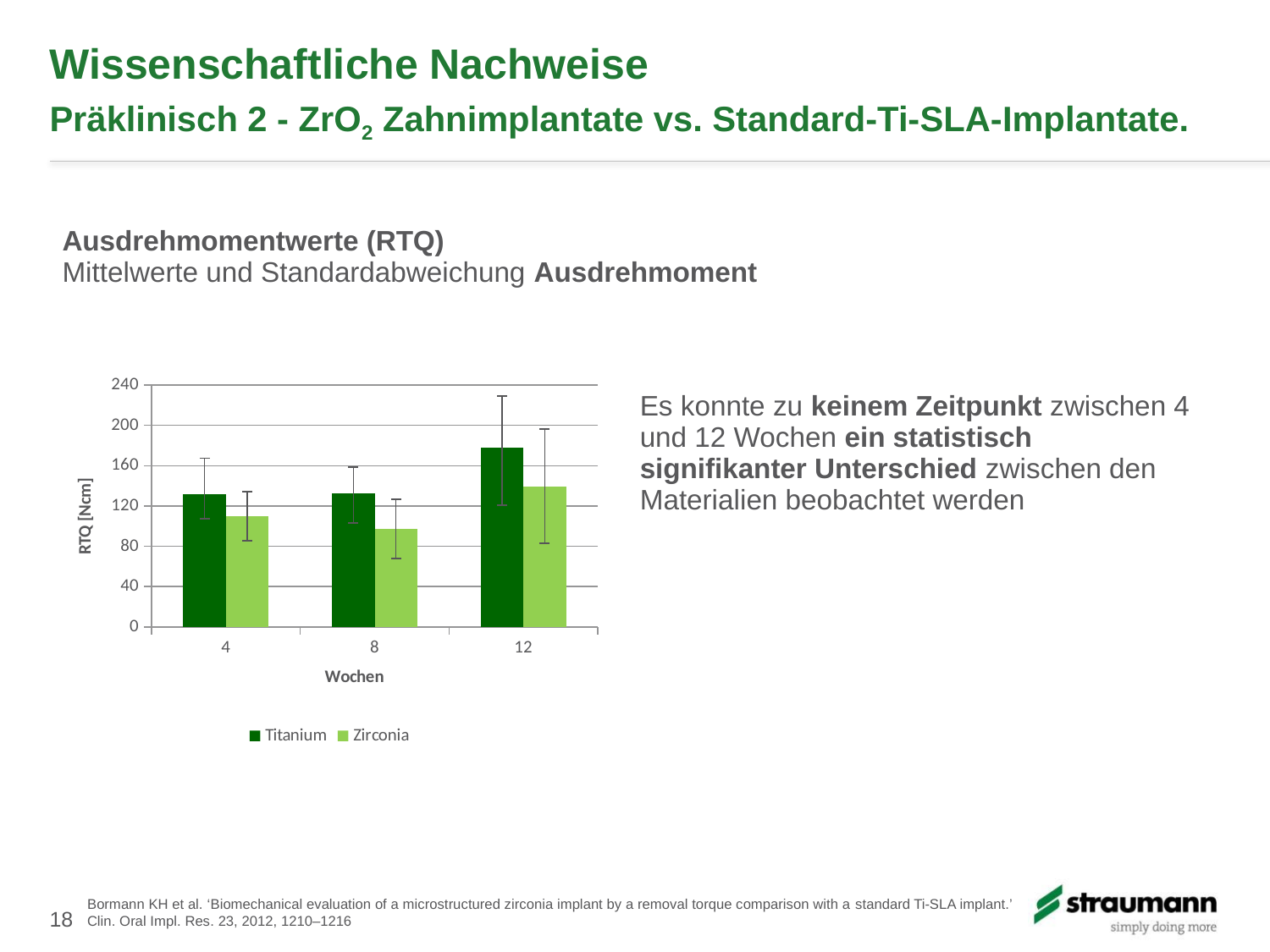
At 12 weeks, which series has the larger RTQ value, Titanium or Zirconia? Titanium At 8 weeks, which series has the larger RTQ value, Titanium or Zirconia? Titanium Is the RTQ value for Titanium at 12 weeks greater or less than 160? greater Which series and week has the lowest RTQ value in the chart? Zirconia at 8 weeks What are the two series named in the chart legend? Titanium and Zirconia Is the RTQ value for Zirconia at 4 weeks greater or less than 80? greater What is the label of the y axis of the chart? RTQ [Ncm] Is the RTQ value for Zirconia at 8 weeks greater or less than 120? less How many series does the chart legend list? 2 How many week categories are shown on the x axis of the chart? 3 Which series and week has the highest RTQ value in the chart? Titanium at 12 weeks What kind of chart is shown on the slide? bar chart